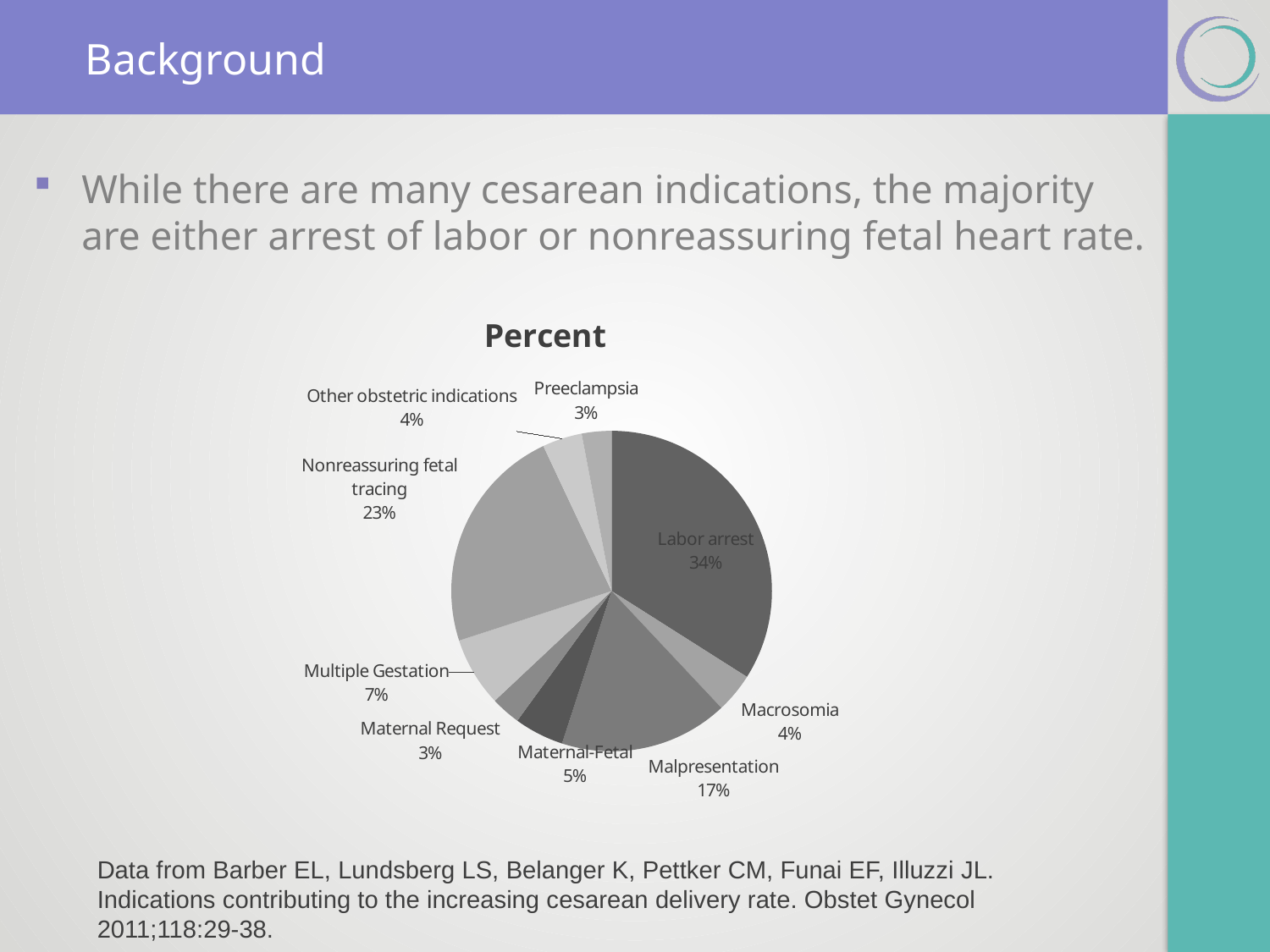
Which indication has the largest share of the pie? Labor arrest What percentage is shown for Multiple Gestation? 7% What is the combined percentage of Labor arrest and Nonreassuring fetal tracing? 57% What percentage of the pie is Labor arrest? 34% What kind of chart is shown on the slide? Pie chart How many slices does the pie chart have? 9 What is the difference in percentage points between Labor arrest and Nonreassuring fetal tracing? 11 What percentage is shown for Malpresentation? 17% What percentage is shown for Nonreassuring fetal tracing? 23% What percentage is shown for Maternal-Fetal? 5% What is the title of the chart? Percent Which is larger, Malpresentation or Multiple Gestation? Malpresentation